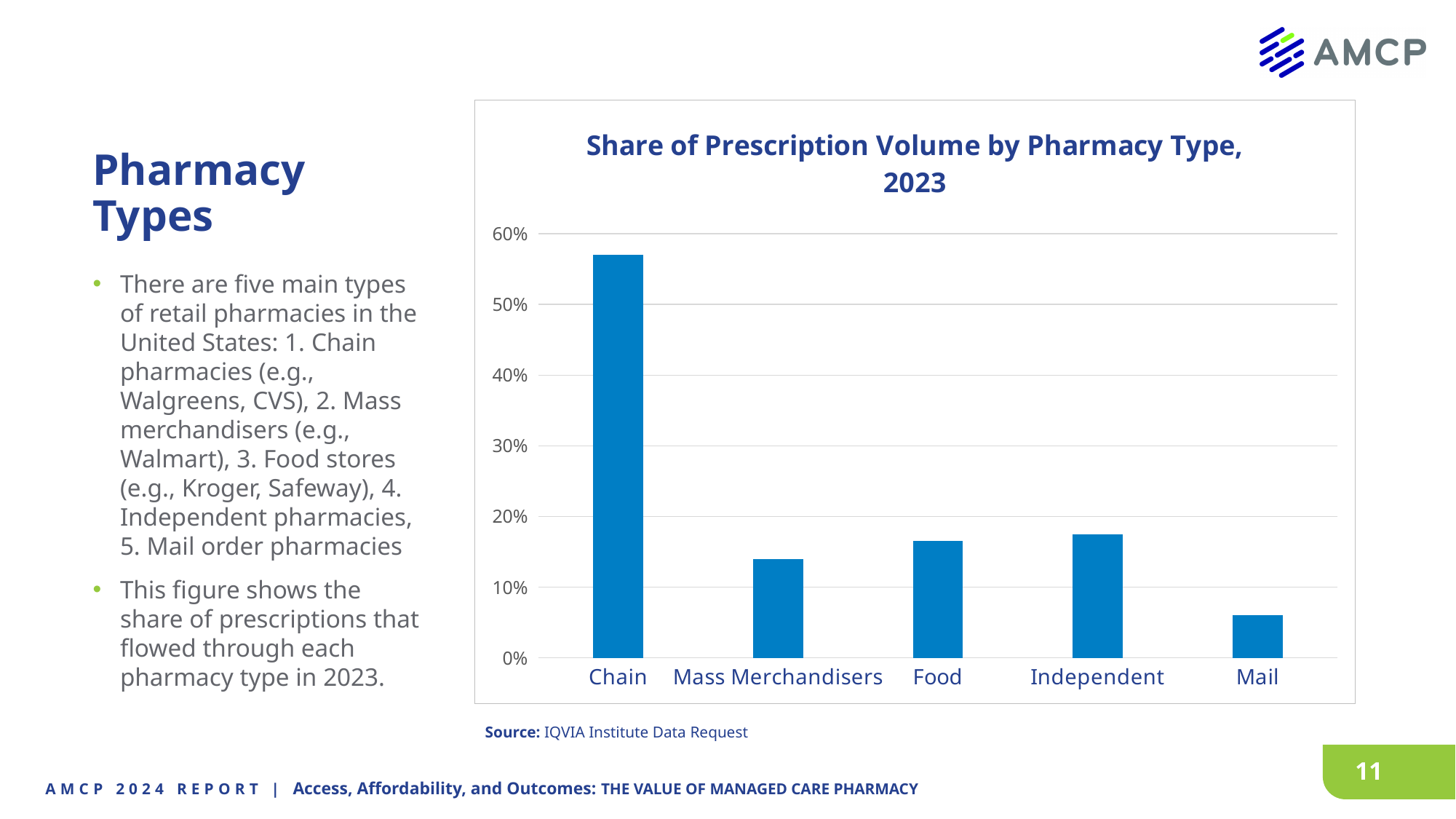
How many pharmacy types are shown on the x axis of the chart? 5 What type of chart is shown on the slide? bar chart Which pharmacy type has the highest share of prescription volume? Chain Is the value for Independent greater or less than 20%? less Which pharmacy type has the lowest share of prescription volume? Mail Is the value for Mail greater or less than 10%? less Is the value for Mass Merchandisers greater or less than 10%? greater What is the title of the chart? Share of Prescription Volume by Pharmacy Type, 2023 Which has a larger share of prescription volume, Mass Merchandisers or Food? Food Which has a larger share of prescription volume, Mail or Independent? Independent